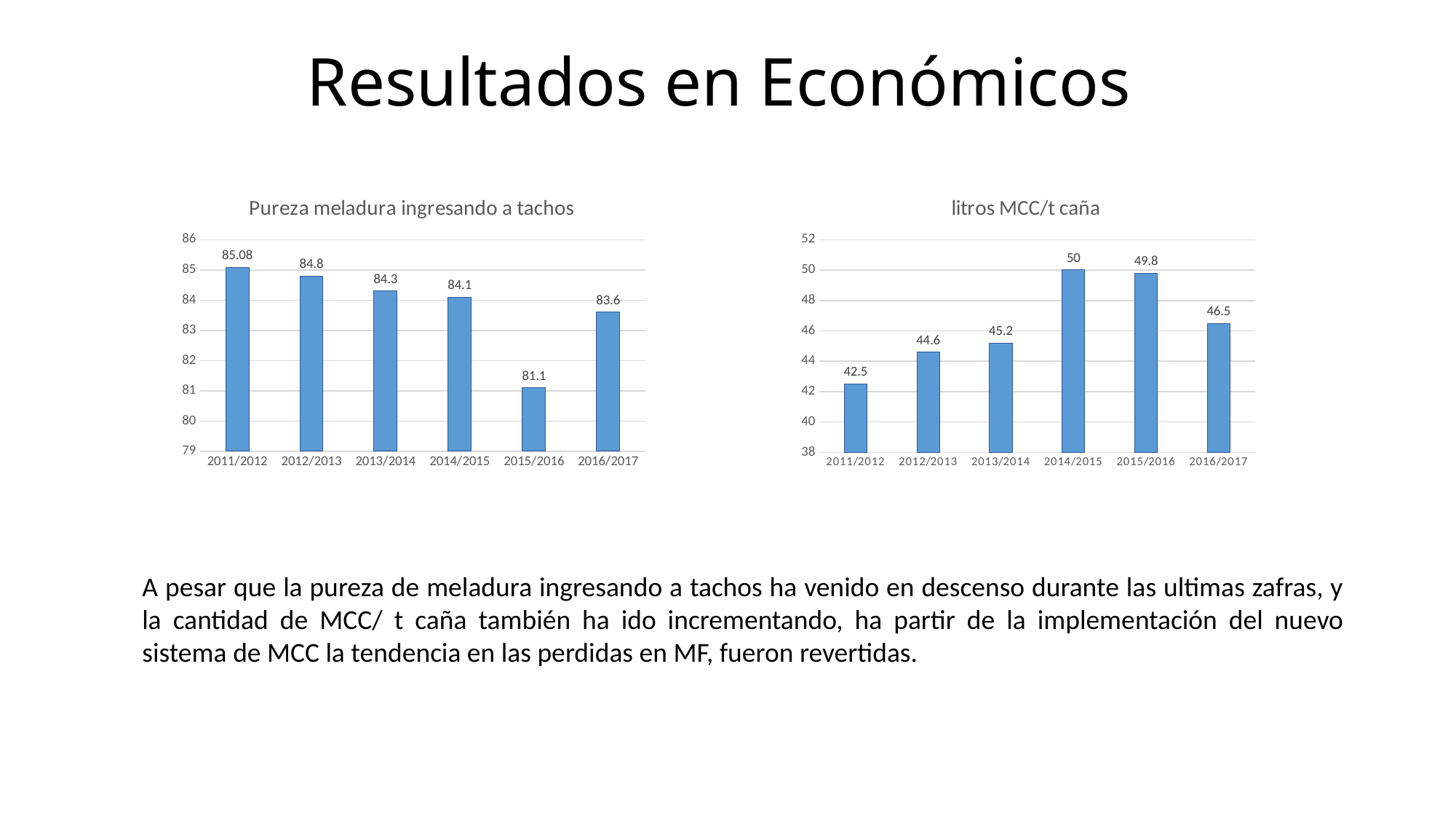
In the 'litros MCC/t caña' chart, is the value for 2015/2016 greater or less than 48? greater In the 'litros MCC/t caña' chart, which is larger, the value for 2012/2013 or 2013/2014? 2013/2014 In the 'Pureza meladura ingresando a tachos' chart, what is the value for 2011/2012? 85.08 In the 'Pureza meladura ingresando a tachos' chart, what is the difference between the values for 2014/2015 and 2015/2016? 3 In the 'litros MCC/t caña' chart, do the values rise or fall from 2011/2012 to 2014/2015? Rise In the 'Pureza meladura ingresando a tachos' chart, how many seasons are shown? 6 What kind of chart is the 'litros MCC/t caña' chart? Bar chart In the 'litros MCC/t caña' chart, what is the difference between the values for 2016/2017 and 2011/2012? 4 In the 'litros MCC/t caña' chart, what is the value for 2014/2015? 50 In the 'litros MCC/t caña' chart, which season has the lowest value? 2011/2012 In the 'Pureza meladura ingresando a tachos' chart, which season has the highest value? 2011/2012 In the 'Pureza meladura ingresando a tachos' chart, which season has the lowest value? 2015/2016